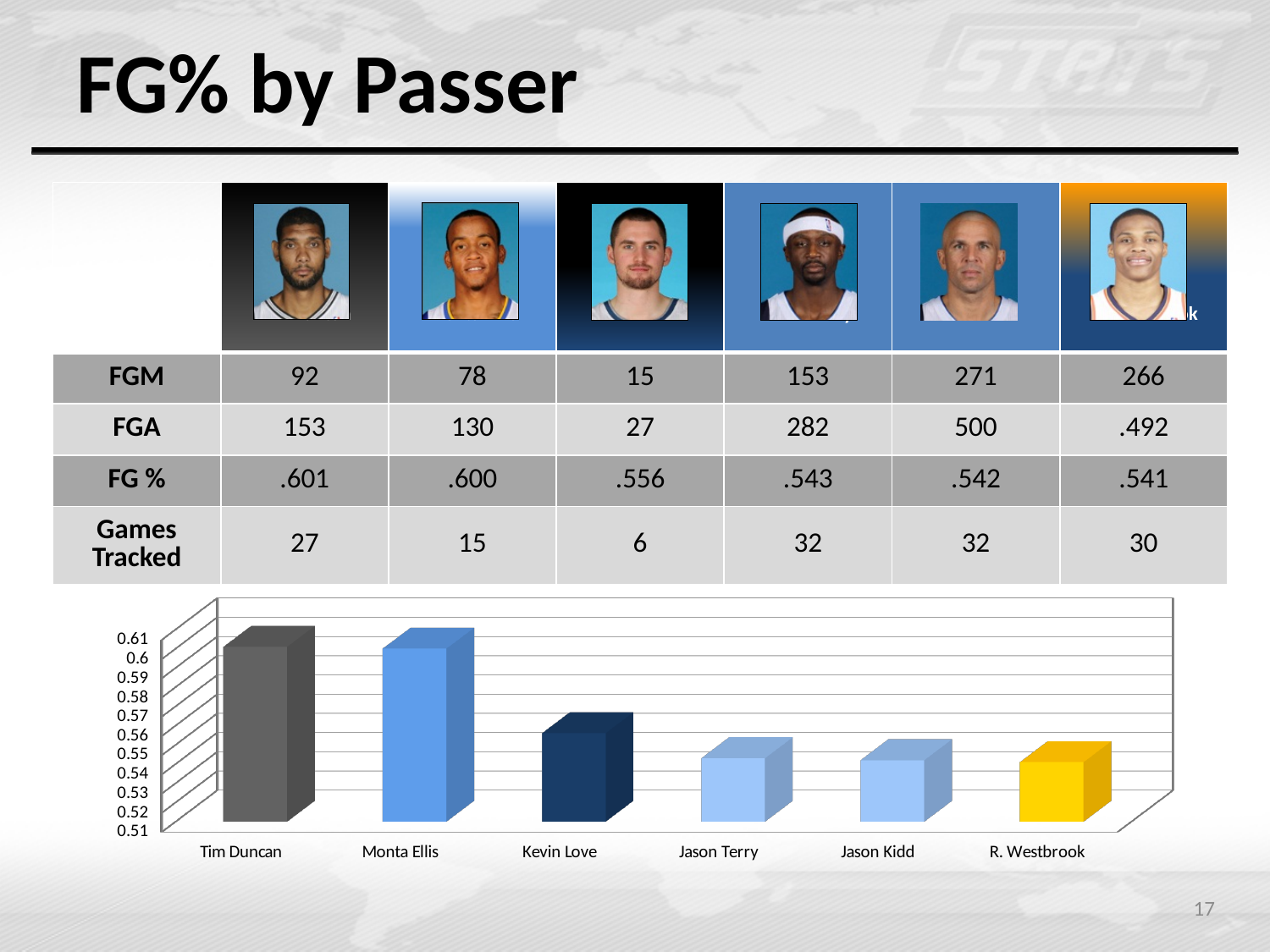
Is the bar for Monta Ellis greater or less than 0.58? greater Is the bar for Jason Terry greater or less than 0.55? less According to the table, what is the FG % for Kevin Love, the value plotted for his bar? .556 Do the bar values rise or fall from left to right across the chart? fall Which bar is taller, Monta Ellis or Jason Kidd? Monta Ellis Is the bar for Tim Duncan greater or less than 0.59? greater How many passers are shown as bars in the chart? 6 What kind of chart is shown at the bottom of the slide? bar chart What is the highest value shown on the chart's vertical axis? 0.61 Which bar is taller, Tim Duncan or Kevin Love? Tim Duncan What is the lowest value shown on the chart's vertical axis? 0.51